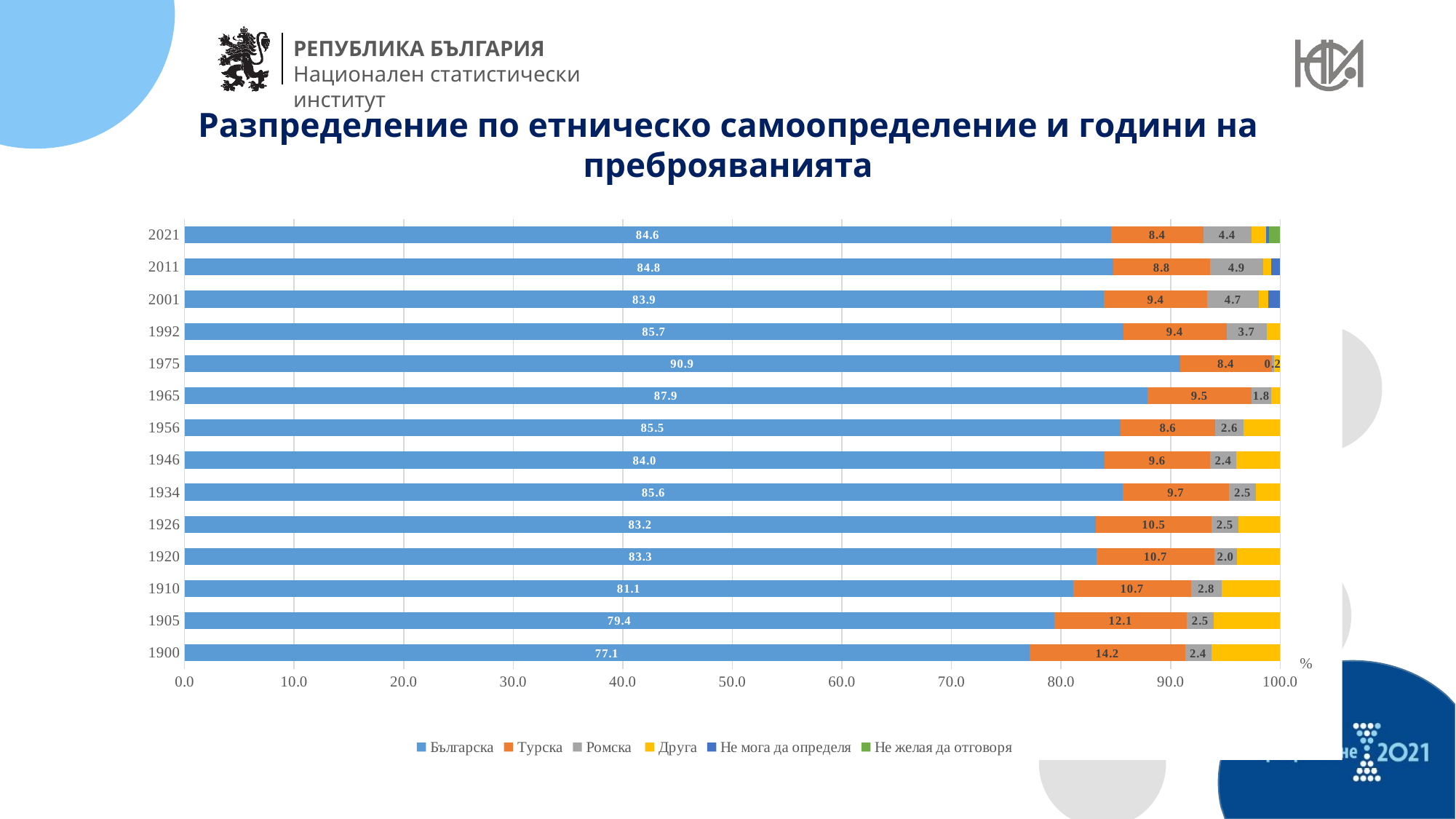
In which year is the value for Българска the highest? 1975 What kind of chart is shown on the slide? bar chart How many series does the legend list? 6 What is the value for Българска in 2021? 84.6 What is the value for Турска in 1900? 14.2 What is the value for Ромска in 2011? 4.9 What is the difference between the Българска values for 2021 and 1900? 7.5 Is the value for Българска in 1900 greater or less than 80.0? less Does the Турска value rise or fall from 1900 to 1934? fall In which year is the value for Българска the lowest? 1900 Which is larger, the Турска value for 1905 or for 1910? 1905 How many census years are shown on the chart? 14